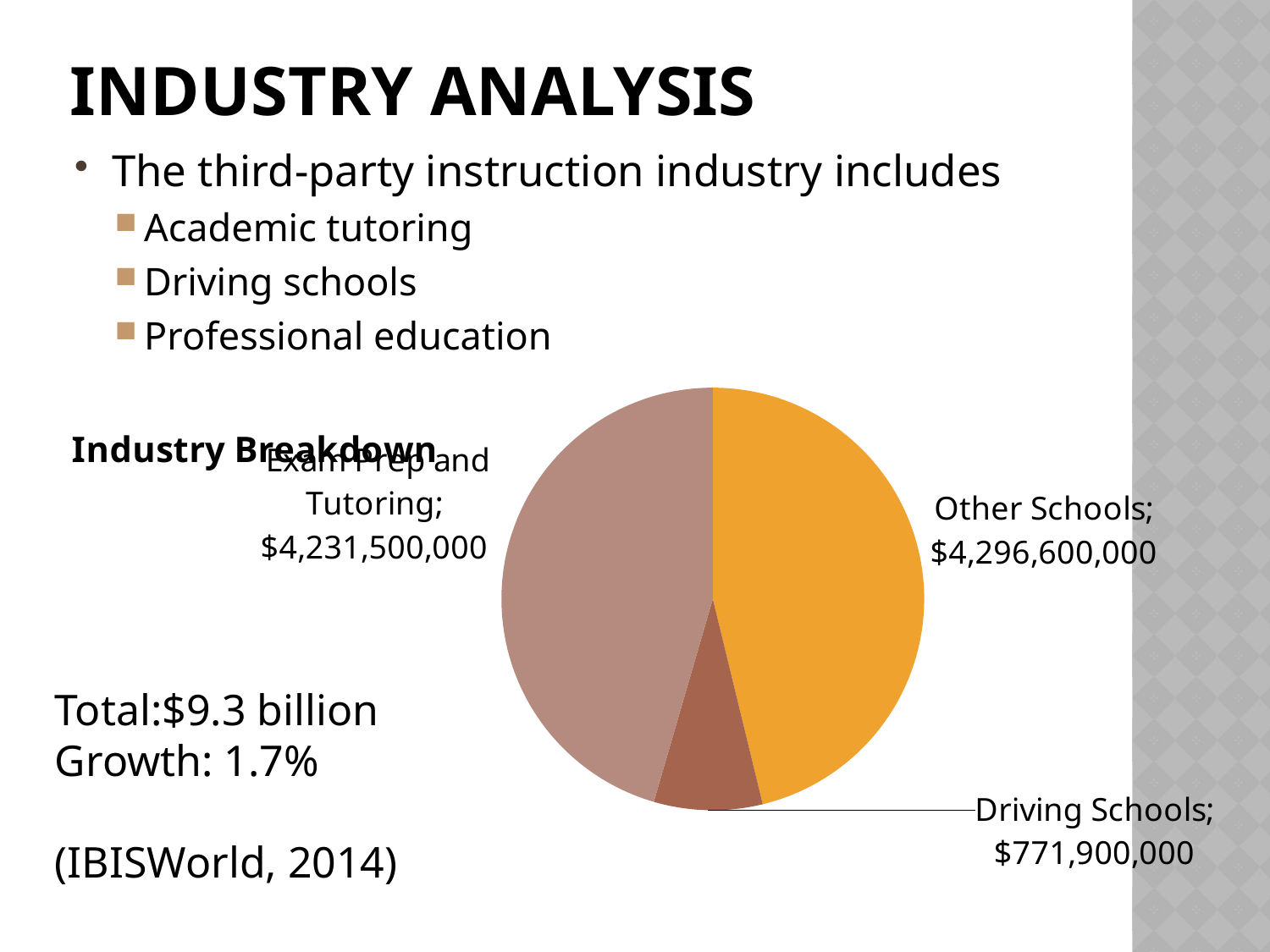
In the Industry Breakdown pie chart, which is larger: Exam Prep and Tutoring or Driving Schools? Exam Prep and Tutoring What is the value for Driving Schools in the Industry Breakdown pie chart? $771,900,000 What is the value for Exam Prep and Tutoring in the Industry Breakdown pie chart? $4,231,500,000 Which category has the smallest slice in the Industry Breakdown pie chart? Driving Schools What is the difference between the Other Schools value and the Exam Prep and Tutoring value in the Industry Breakdown pie chart? $65,100,000 What is the title of the pie chart on the slide? Industry Breakdown What is the total of all three slices in the Industry Breakdown pie chart? $9,300,000,000 Which category has the largest slice in the Industry Breakdown pie chart? Other Schools What is the difference between the Other Schools value and the Driving Schools value in the Industry Breakdown pie chart? $3,524,700,000 How many categories are shown in the Industry Breakdown pie chart? 3 What kind of chart is the Industry Breakdown chart? Pie chart What is the value for Other Schools in the Industry Breakdown pie chart? $4,296,600,000